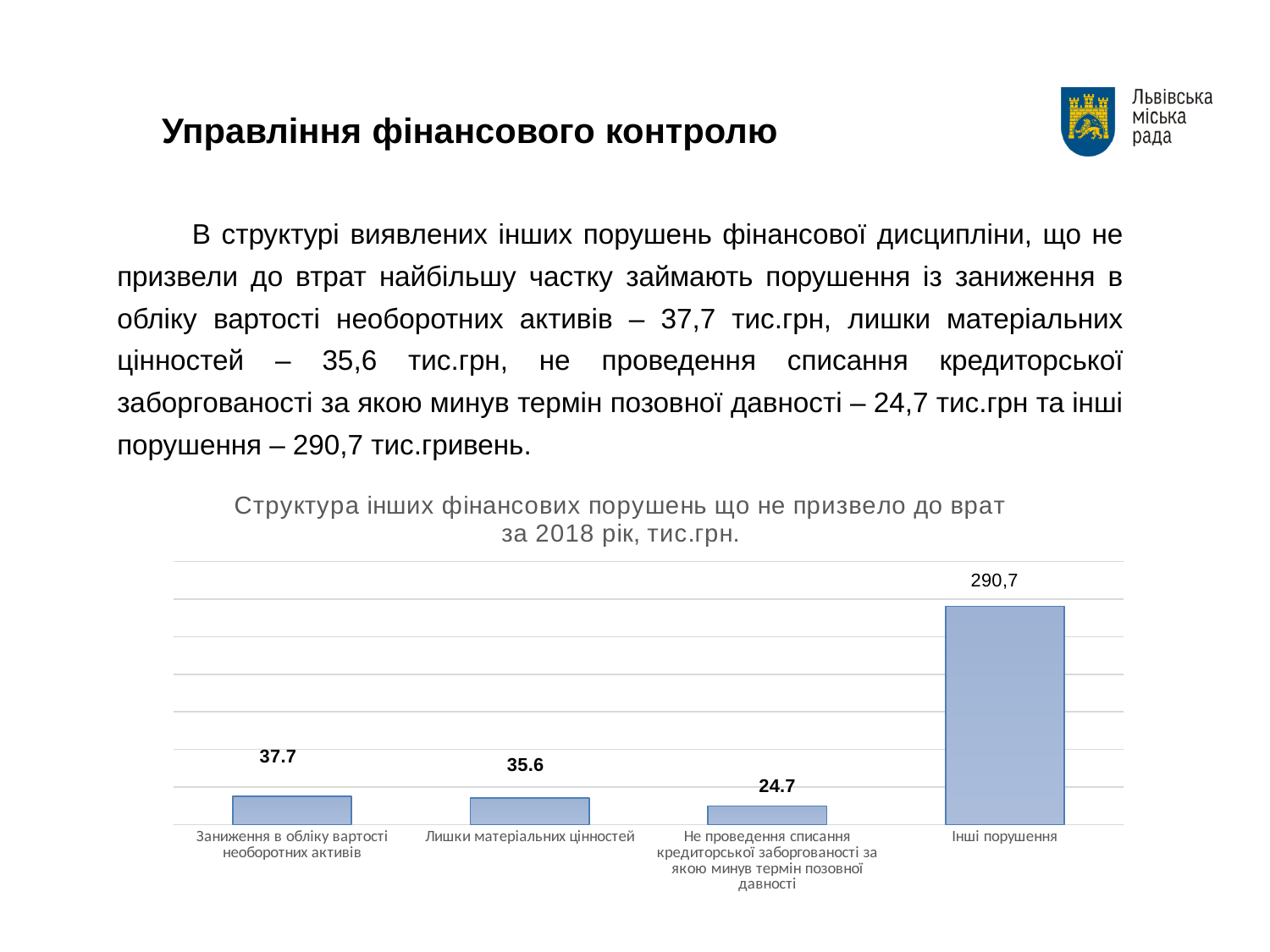
What is the value for "Не проведення списання кредиторської заборгованості за якою минув термін позовної давності"? 24.7 What is the difference between the values for "Заниження в обліку вартості необоротних активів" and "Лишки матеріальних цінностей"? 2.1 What is the value for "Інші порушення"? 290,7 What is the value for "Лишки матеріальних цінностей"? 35.6 What is the title of the chart? Структура інших фінансових порушень що не призвело до врат за 2018 рік, тис.грн. What is the difference between the values for "Лишки матеріальних цінностей" and "Не проведення списання кредиторської заборгованості за якою минув термін позовної давності"? 10.9 What kind of chart is shown on the slide? Bar chart Which category has the highest value? Інші порушення What is the value for "Заниження в обліку вартості необоротних активів"? 37.7 How many categories are shown in the chart? 4 Which is larger: the value for "Заниження в обліку вартості необоротних активів" or the value for "Лишки матеріальних цінностей"? Заниження в обліку вартості необоротних активів Which category has the lowest value? Не проведення списання кредиторської заборгованості за якою минув термін позовної давності